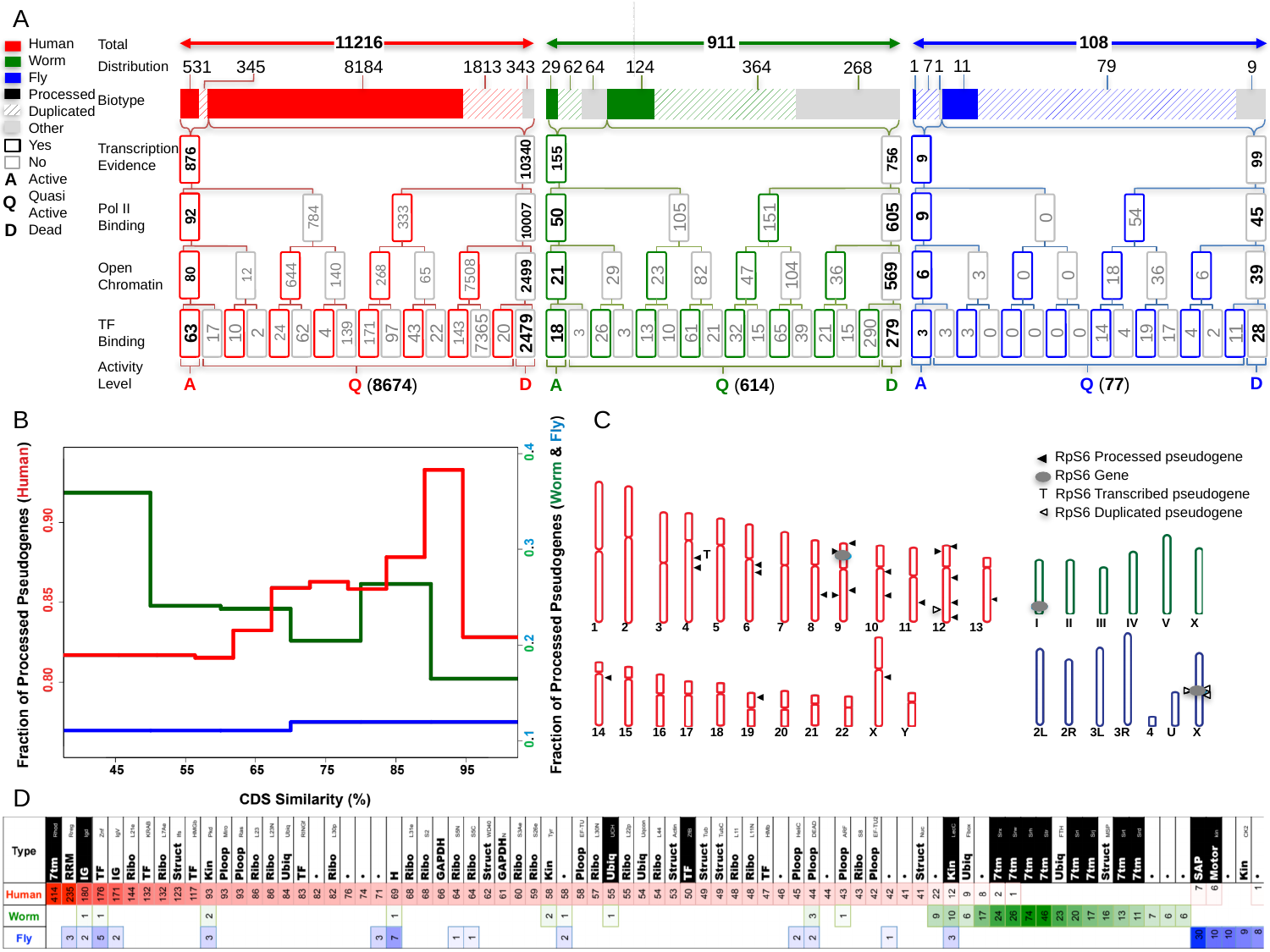
In panel B, is the Worm line at 45% CDS similarity greater or less than 0.3 on the right axis? greater In panel A, what is the difference between the human total and the worm total? 10305 In panel A, what is the total number of worm pseudogenes shown? 911 In panel A, what is the total number of human pseudogenes shown? 11216 In panel A, how many species are compared? 3 What is the x-axis label of the chart in panel B? CDS Similarity (%) In panel A, which species has the highest total number of pseudogenes? Human What kind of chart is panel B? line chart In panel A, how many human pseudogenes are at the quasi-active (Q) activity level? 8674 In panel C, how many entries does the legend list? 4 In panel A, what is the total number of fly pseudogenes shown? 108 In panel A, how many human pseudogenes have transcription evidence (Yes)? 876